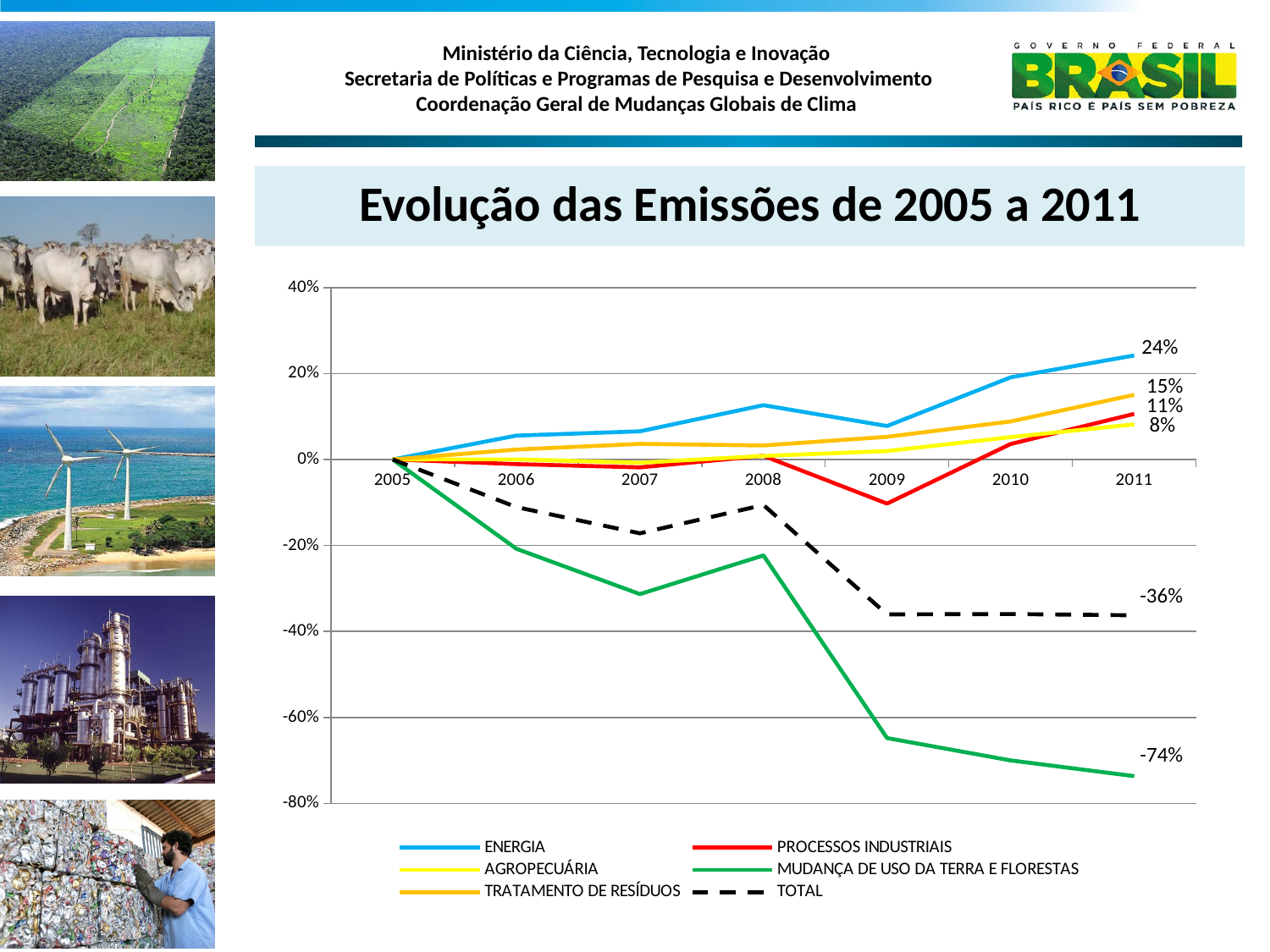
Which series has the lowest value in 2011? MUDANÇA DE USO DA TERRA E FLORESTAS How many series does the legend list? 6 What is the value for ENERGIA in 2011? 24% Is the value for MUDANÇA DE USO DA TERRA E FLORESTAS in 2009 greater or less than -60%? less Does the ENERGIA series rise or fall overall from 2005 to 2011? rise Which series has the highest value in 2011? ENERGIA What type of chart is shown on the slide? line chart How many years are plotted along the x axis? 7 What is the value for TOTAL in 2011? -36% What is the title of the chart? Evolução das Emissões de 2005 a 2011 What is the difference between the 2011 values of ENERGIA (24%) and TRATAMENTO DE RESÍDUOS (15%)? 9 percentage points What is the value for MUDANÇA DE USO DA TERRA E FLORESTAS in 2011? -74%